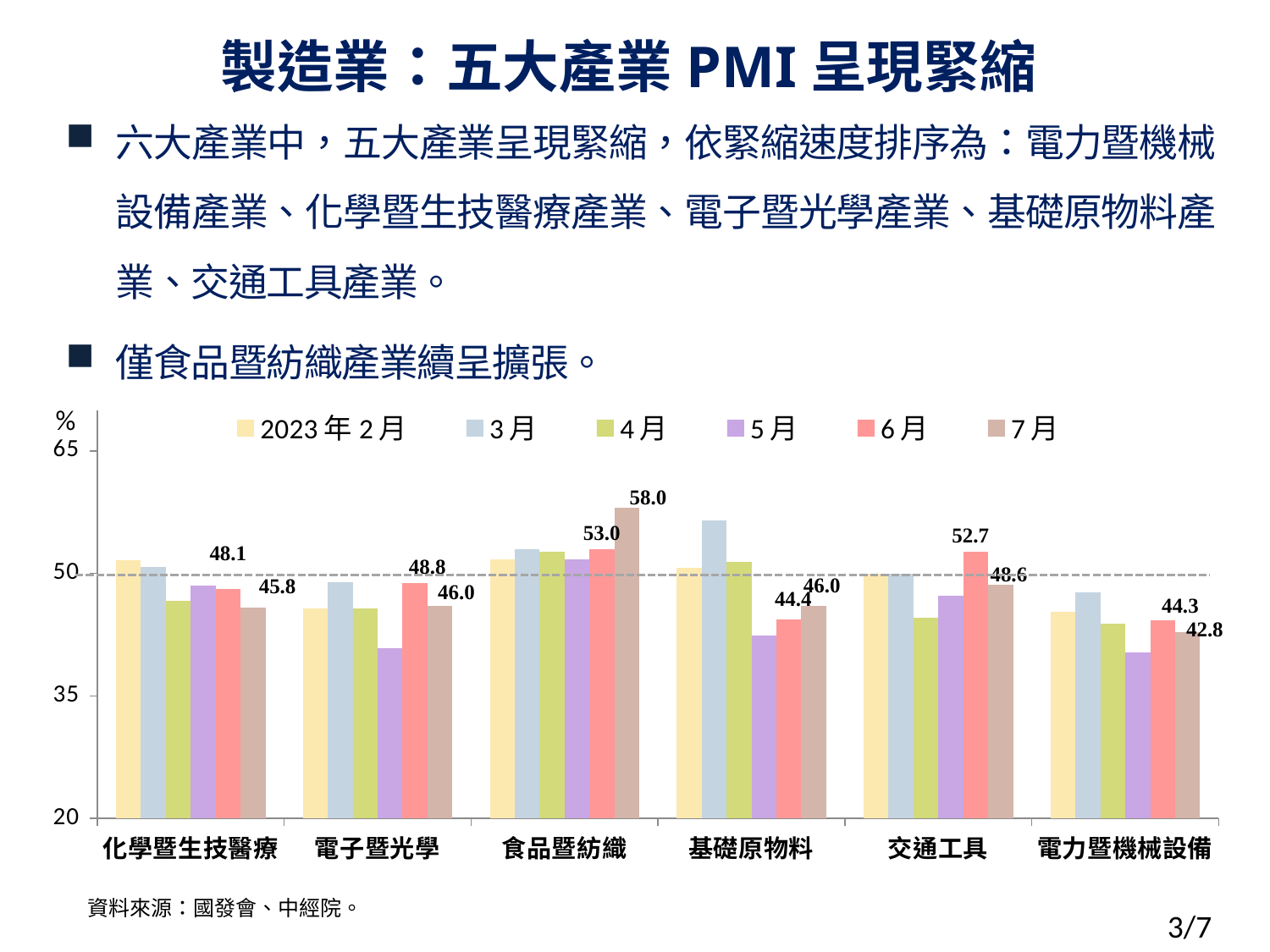
Which industry has the highest 7月 value? 食品暨紡織 What is the 7月 value for 食品暨紡織? 58.0 Which is larger for 交通工具: the 6月 value or the 7月 value? 6月 How many industries are shown on the x axis? 6 What is the 7月 value for 電力暨機械設備? 42.8 Which industry has the lowest 7月 value? 電力暨機械設備 What is the 6月 value for 交通工具? 52.7 How many series does the legend list? 6 What kind of chart is shown on the slide? bar chart Is the 5月 value for 電子暨光學 greater or less than 50? less What is the 6月 value for 基礎原物料? 44.4 What is the difference between the 7月 and 6月 values for 食品暨紡織? 5.0